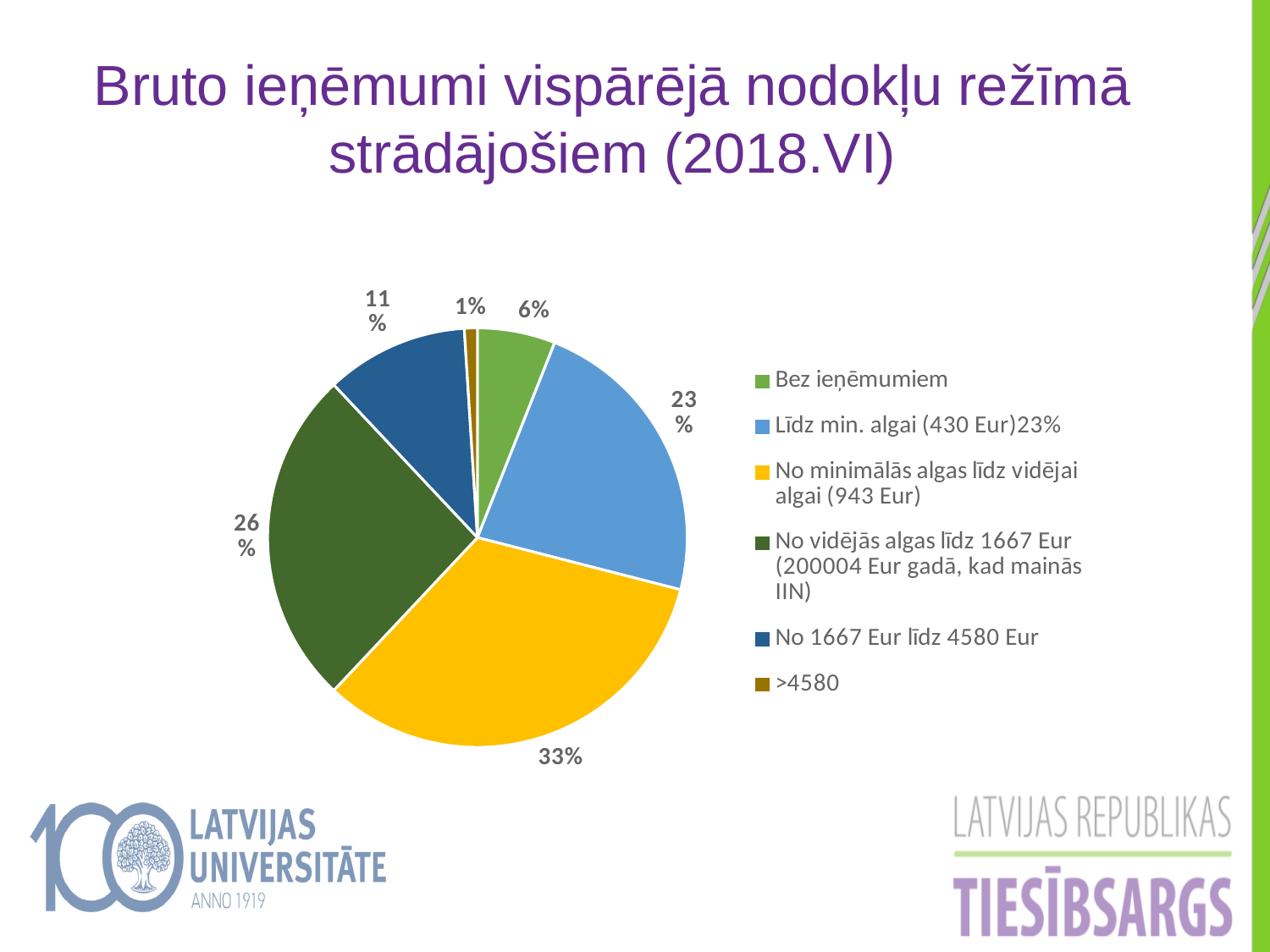
What share of the pie does the ">4580" slice represent? 1% Which category has the largest slice of the pie? No minimālās algas līdz vidējai algai (943 Eur) Which slice is larger: "Līdz min. algai (430 Eur)" or "No 1667 Eur līdz 4580 Eur"? Līdz min. algai (430 Eur) What share of the pie does the "No vidējās algas līdz 1667 Eur" slice represent? 26% What share of the pie does the "Bez ieņēmumiem" slice represent? 6% What is the difference in percentage points between the "No minimālās algas līdz vidējai algai (943 Eur)" slice and the "No vidējās algas līdz 1667 Eur" slice? 7 Which category has the smallest slice of the pie? >4580 How many categories does the legend of the pie chart list? 6 What type of chart is shown on the slide? pie chart